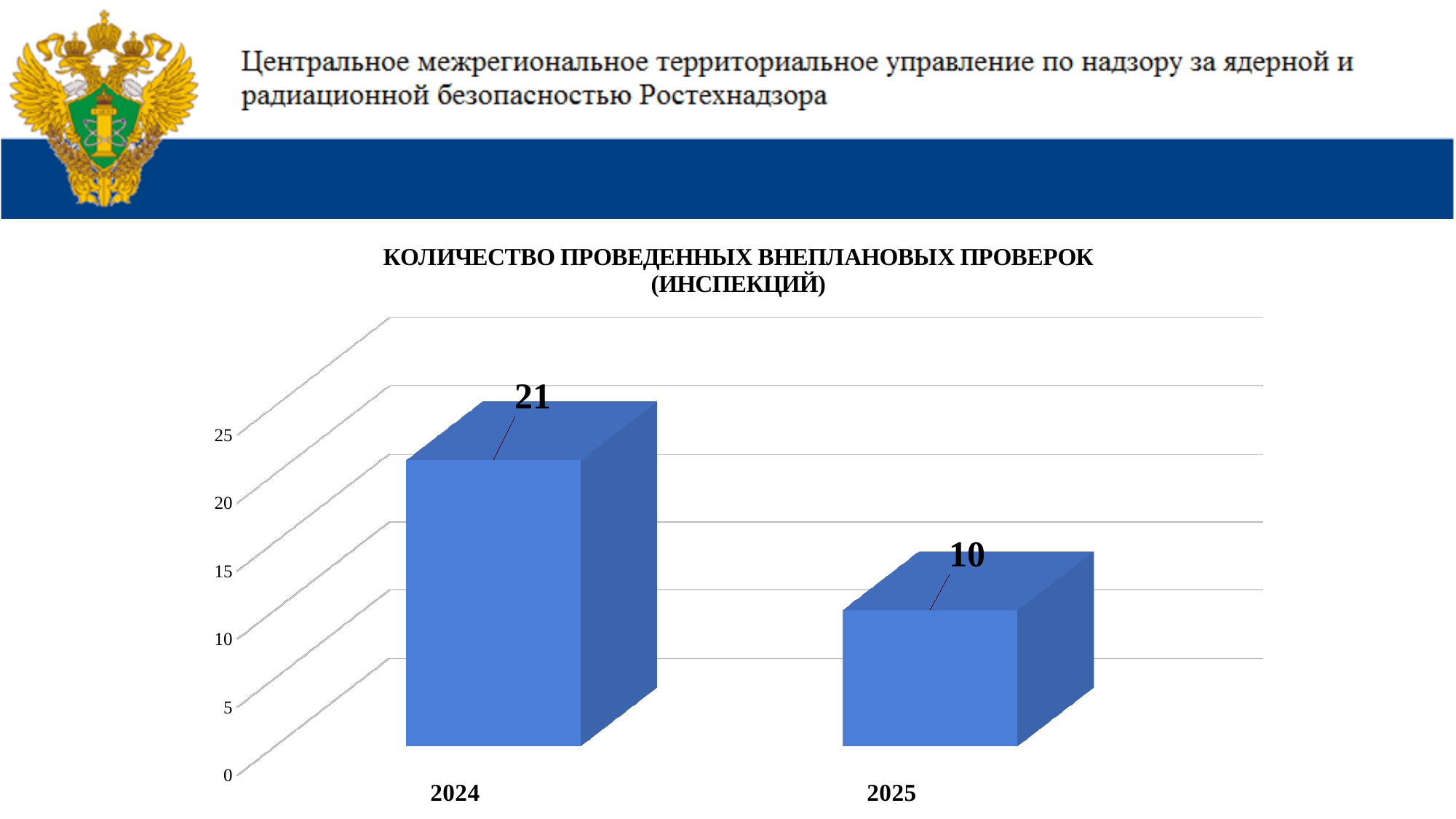
What is the difference between the values for 2024 and 2025? 11 Is the value for 2025 greater or less than 15? less Which year has the lowest value? 2025 What is the value for 2024? 21 What is the value for 2025? 10 What is the title of the chart? КОЛИЧЕСТВО ПРОВЕДЕННЫХ ВНЕПЛАНОВЫХ ПРОВЕРОК (ИНСПЕКЦИЙ) Do the values rise or fall from 2024 to 2025? fall Which year has the highest value? 2024 What kind of chart is shown on the slide? bar chart Which is larger, the value for 2024 or the value for 2025? 2024 Is the value for 2024 greater or less than 20? greater How many categories are shown on the x axis? 2